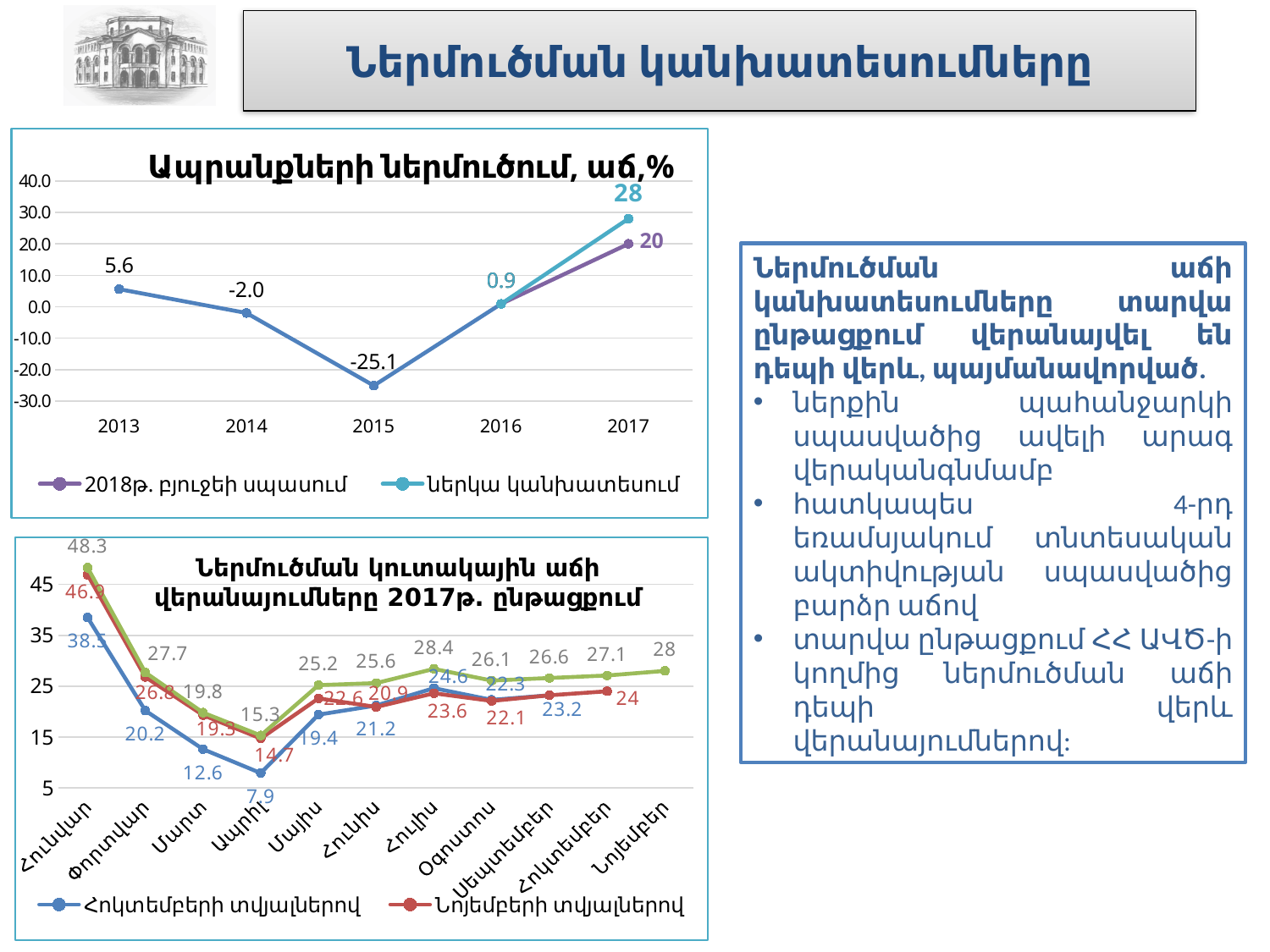
In the bottom chart, how many months are shown on the x axis? 11 What kind of chart is the bottom chart 'Ներմուծման կուտակային աճի վերանայումները 2017թ. ընթացքում'? line chart In the top chart 'Ապրանքների ներմուծում, աճ,%', how many series does the legend list? 2 In the top chart 'Ապրանքների ներմուծում, աճ,%', what is the value for 2015? -25.1 In the top chart 'Ապրանքների ներմուծում, աճ,%', what is the value for 2013? 5.6 In the top chart 'Ապրանքների ներմուծում, աճ,%', what is the 2017 value for the '2018թ. բյուջեի սպասում' series? 20 In the bottom chart, what is the value for Ապրիլ in the 'Հոկտեմբերի տվյալներով' series? 7.9 In the top chart 'Ապրանքների ներմուծում, աճ,%', what is the 2017 value for the 'ներկա կանխատեսում' series? 28 In the top chart 'Ապրանքների ներմուծում, աճ,%', which year has the lowest value? 2015 In the bottom chart, what is the value for Հունվար in the 'Նոյեմբերի տվյալներով' series? 46.9 In the top chart 'Ապրանքների ներմուծում, աճ,%', what is the difference between the 2017 values of 'ներկա կանխատեսում' and '2018թ. բյուջեի սպասում'? 8 In the top chart 'Ապրանքների ներմուծում, աճ,%', how many years are shown on the x axis? 5